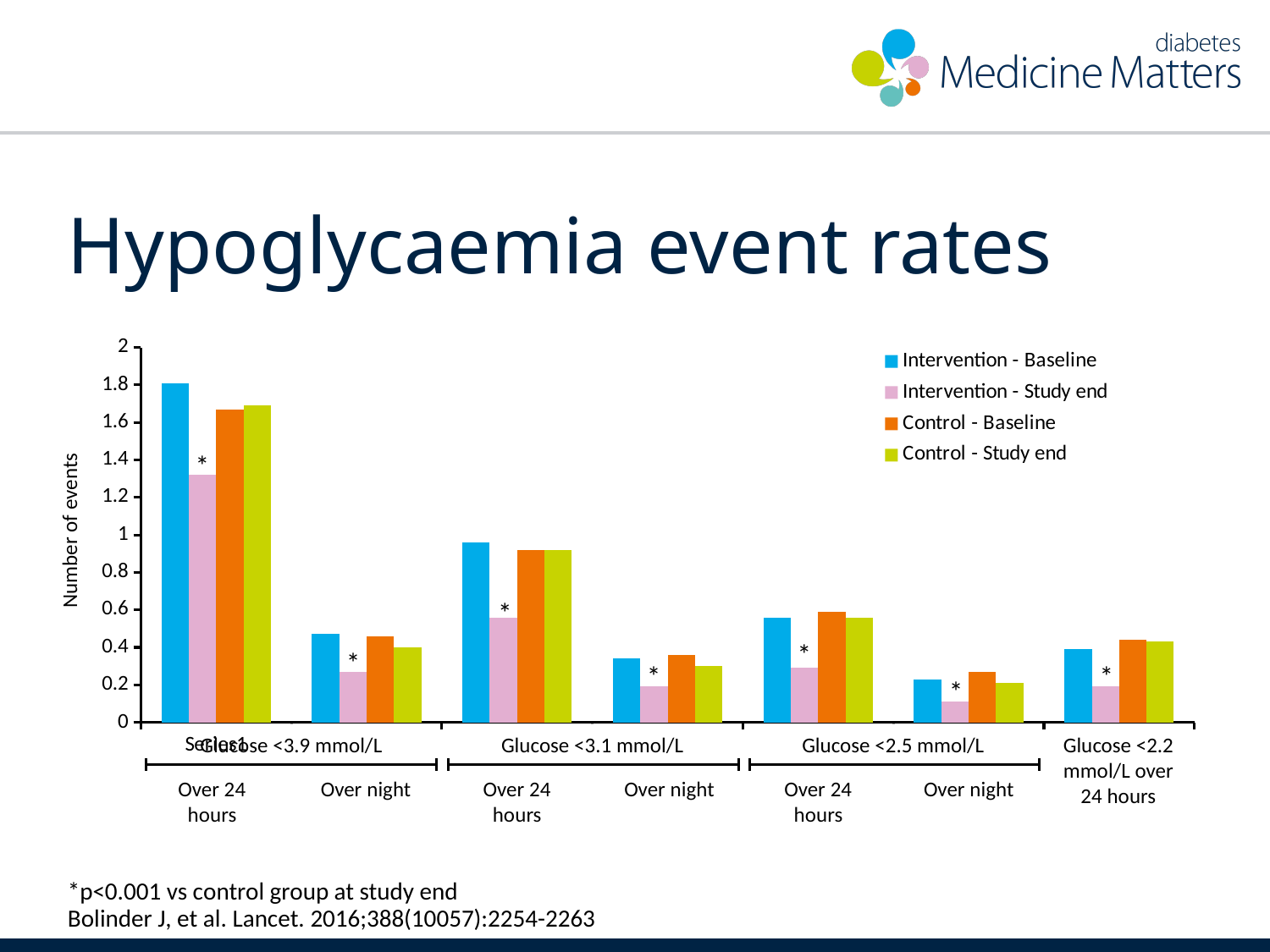
For Glucose <2.5 mmol/L over 24 hours, which is larger: Intervention - Baseline or Intervention - Study end? Intervention - Baseline What kind of chart is shown on the slide? Bar chart For Glucose <3.9 mmol/L over 24 hours, which series has the highest number of events? Intervention - Baseline What does the asterisk above some bars indicate, according to the footnote? p<0.001 vs control group at study end For Glucose <3.9 mmol/L over 24 hours, which series has the lowest number of events? Intervention - Study end What is the label on the vertical axis? Number of events Is the Intervention - Study end value for Glucose <2.5 mmol/L over night greater or less than 0.2? less How many series does the legend list? 4 Is the Intervention - Study end value for Glucose <3.9 mmol/L over 24 hours greater or less than 1.4? less How many glucose threshold groups are shown along the x axis? 4 For Glucose <2.2 mmol/L over 24 hours, which is larger: Control - Baseline or Intervention - Study end? Control - Baseline Is the Intervention - Baseline value for Glucose <3.1 mmol/L over 24 hours greater or less than 0.8? greater